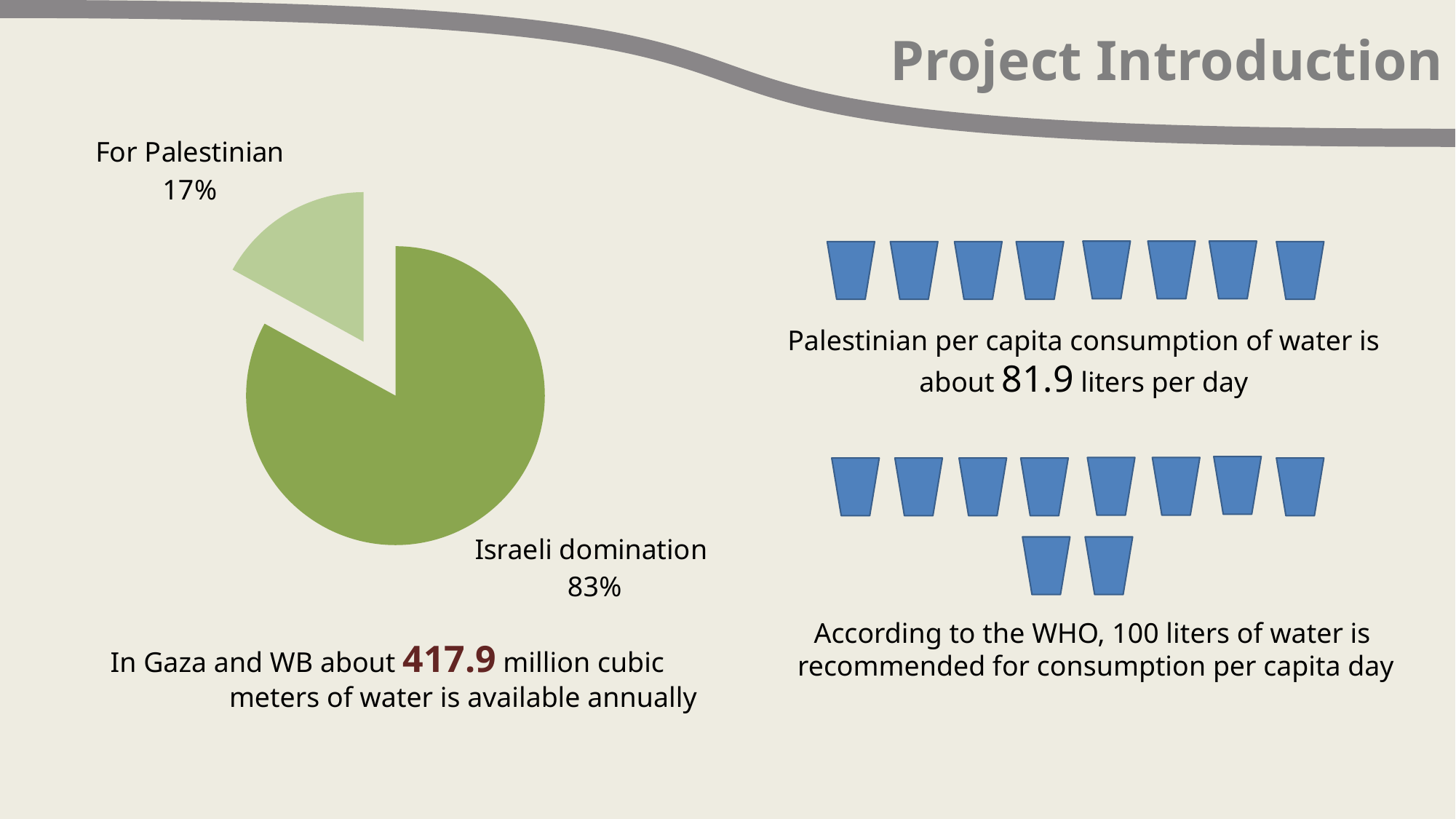
Which slice of the pie chart is the smallest? For Palestinian In the pie chart, what share is labelled "For Palestinian"? 17% Is the For Palestinian share of the pie chart greater or less than 20%? less What is the difference in percentage points between the Israeli domination slice and the For Palestinian slice? 66 What kind of chart is shown on the left of the slide? pie chart Which slice of the pie chart is the largest? Israeli domination What colour is the Israeli domination slice of the pie chart? green Which is larger in the pie chart, the For Palestinian slice or the Israeli domination slice? Israeli domination Is the For Palestinian slice of the pie chart pulled out (exploded) from the rest of the pie? yes How many bucket icons are shown in the top row of the pictogram on the right, representing Palestinian per capita consumption? 8 In the pie chart, what share is labelled "Israeli domination"? 83% How many slices does the pie chart have? 2